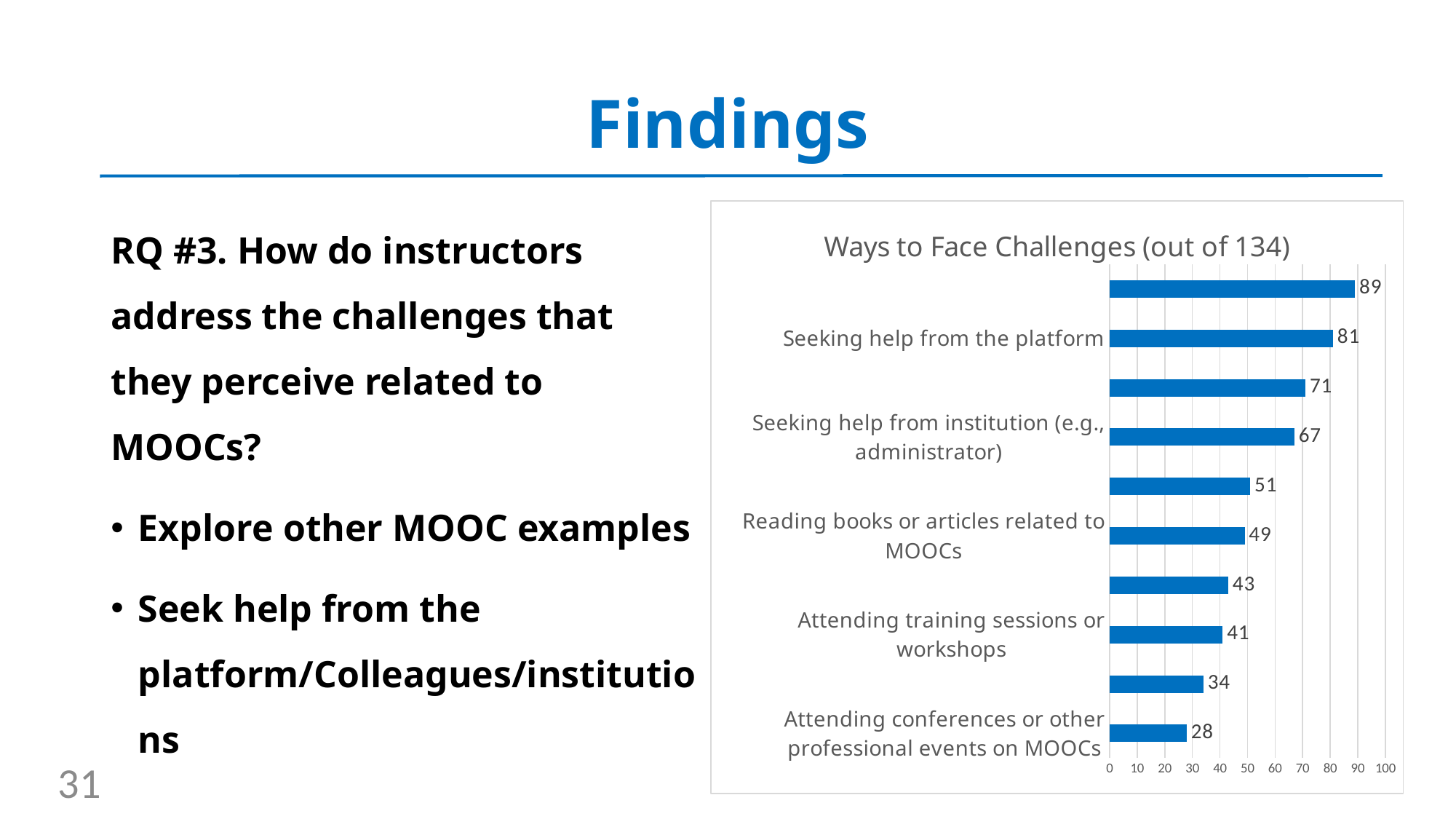
What is the value for "Seeking help from institution (e.g., administrator)"? 67 Which is larger: the value for "Reading books or articles related to MOOCs" or the value for "Attending training sessions or workshops"? Reading books or articles related to MOOCs What is the difference between the values for "Seeking help from the platform" and "Seeking help from institution (e.g., administrator)"? 14 What kind of chart is shown on the slide? bar chart Which labeled category has the lowest value? Attending conferences or other professional events on MOOCs What is the value for "Attending training sessions or workshops"? 41 What is the title of the chart? Ways to Face Challenges (out of 134) What is the value for "Attending conferences or other professional events on MOOCs"? 28 How many bars are plotted in the chart? 10 Is the value for "Seeking help from the platform" greater or less than 70? greater What is the value for "Seeking help from the platform"? 81 What is the value for "Reading books or articles related to MOOCs"? 49